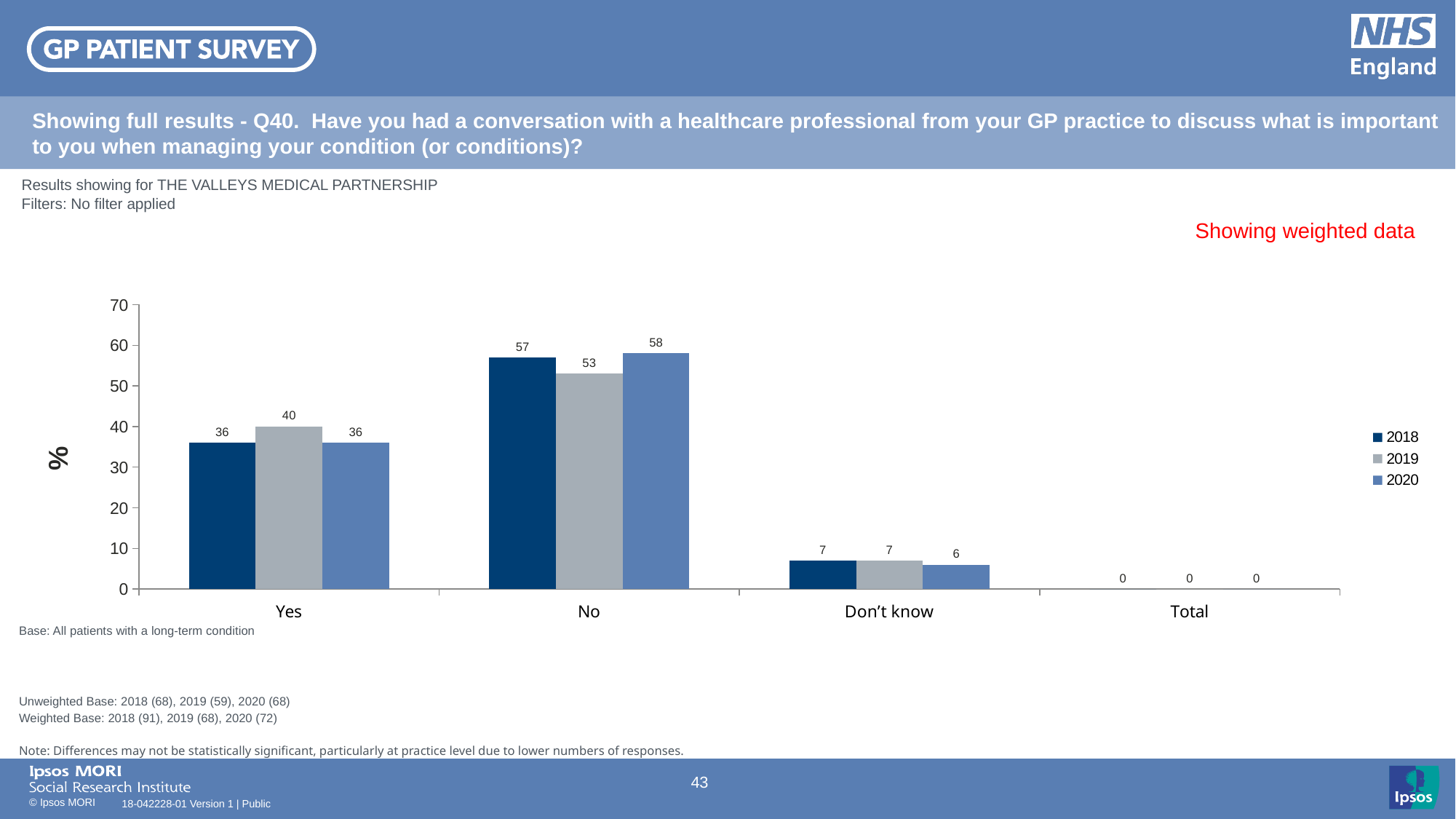
What is the value for 'Yes' in 2019? 40 Which category has the highest value for 2018? No What is the value for 'Don't know' in 2020? 6 What label is shown on the y axis? % What kind of chart is shown? bar chart Is the value for 'No' in 2019 greater or less than 50? greater Which is larger: the 2019 value for 'Yes' or the 2020 value for 'Yes'? 2019 How many categories are shown on the x axis? 4 Which year has the lowest value for 'No'? 2019 How many series does the legend list? 3 What is the difference between the 2018 and 2019 values for 'No'? 4 What is the value for 'No' in 2020? 58